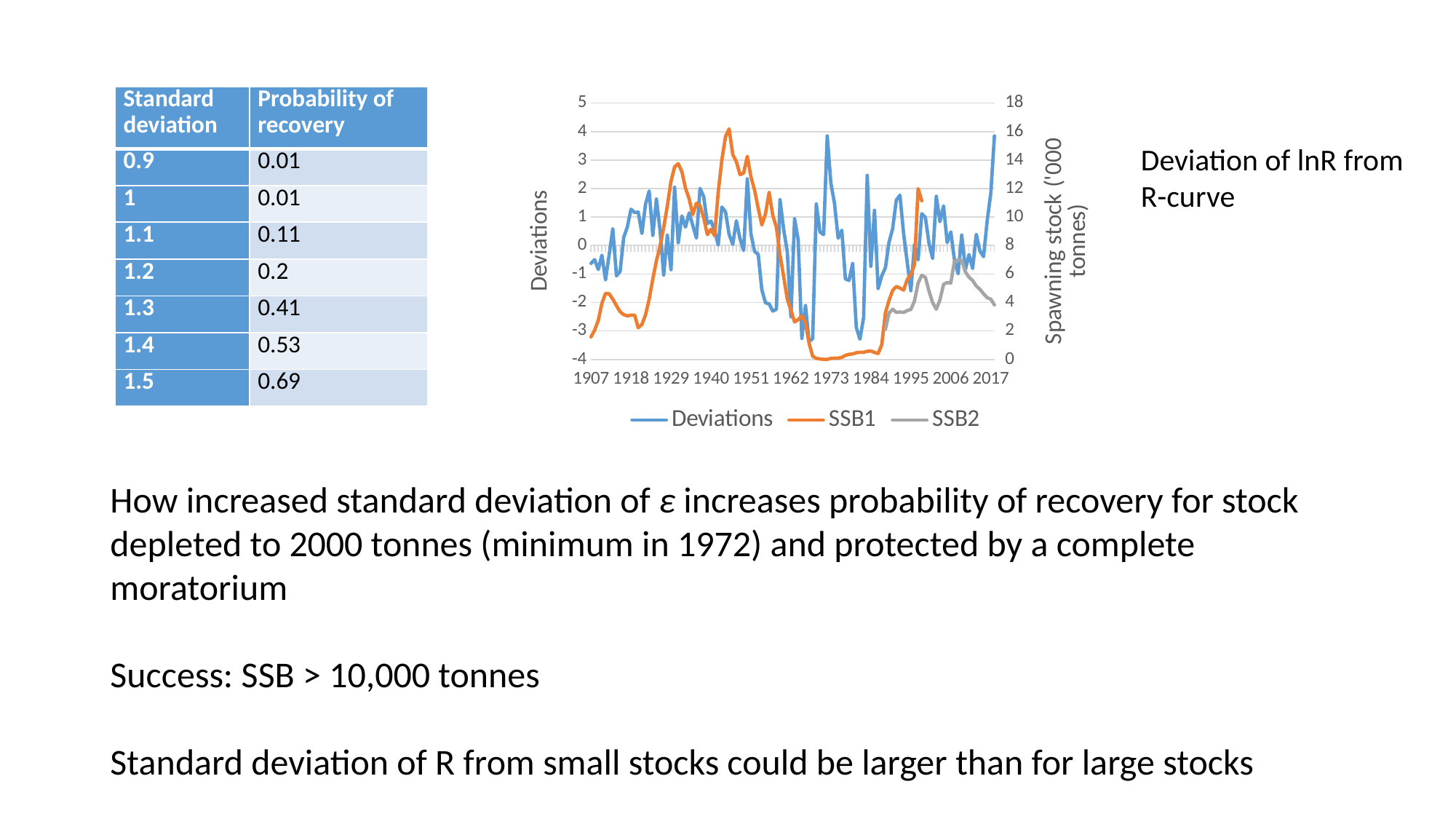
Does the SSB1 series rise or fall between 1984 and 1995? rise What is the title of the right-hand vertical axis of the chart? Spawning stock ('000 tonnes) Is the value of the SSB1 series around 1973 greater or less than 2 on the right-hand axis? less How many series does the chart's legend list? 3 Does the SSB2 series rise or fall between 2006 and 2017? fall Is the peak value of the SSB1 series around 1945 greater or less than 12 on the right-hand axis? greater Is the peak of the Deviations series around 1972 greater or less than 3 on the left-hand axis? greater What are the three series named in the chart's legend? Deviations, SSB1, SSB2 How many year labels are shown along the x axis of the chart? 11 What kind of chart is shown on the slide? line chart